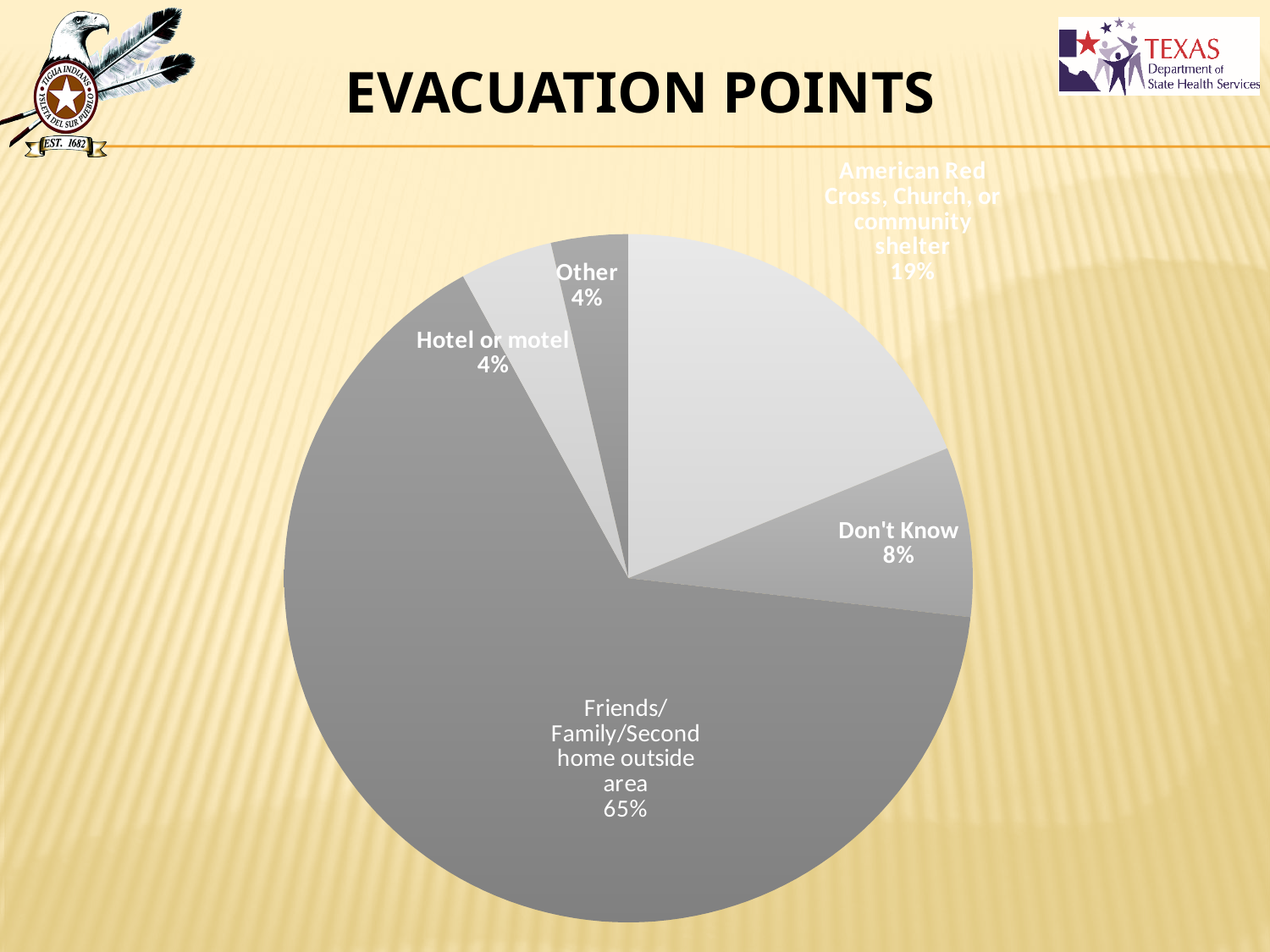
What is the difference in percentage points between American Red Cross, Church, or community shelter and Don't Know? 11 Which is larger, the share for Don't Know or the share for Hotel or motel? Don't Know What share of the pie is Friends/Family/Second home outside area? 65% What is the title of the slide containing the chart? EVACUATION POINTS What percentage is shown for American Red Cross, Church, or community shelter? 19% What percentage is shown for Other? 4% Which category has the largest slice of the pie? Friends/Family/Second home outside area How many slices does the pie chart have? 5 What kind of chart is shown on the slide? pie chart What is the difference in percentage points between Friends/Family/Second home outside area and American Red Cross, Church, or community shelter? 46 What percentage is shown for Hotel or motel? 4% What percentage is shown for Don't Know? 8%